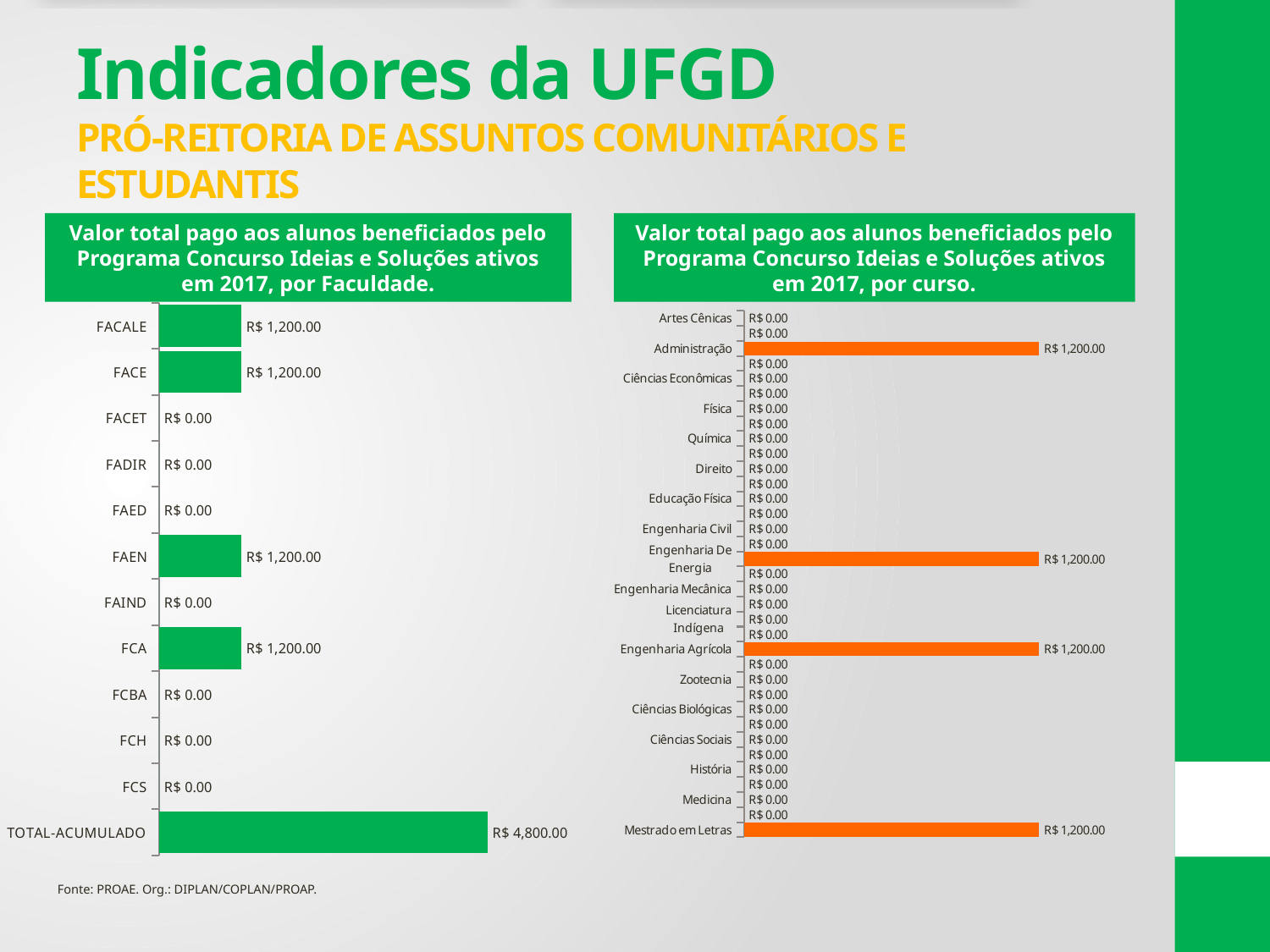
In the right chart (por curso), what is the value for Mestrado em Letras? R$ 1,200.00 In the right chart (por curso), what is the value for Administração? R$ 1,200.00 In the right chart (por curso), what is the value for Engenharia Agrícola? R$ 1,200.00 In the left chart (por Faculdade), what is the difference between TOTAL-ACUMULADO and FAEN? R$ 3,600.00 In the left chart (por Faculdade), what is the value for FACALE? R$ 1,200.00 What colour are the bars in the right chart (por curso)? Orange In the left chart (por Faculdade), which is larger, the value for FCA or the value for FCBA? FCA In the left chart (por Faculdade), which category has the highest value? TOTAL-ACUMULADO In the left chart (por Faculdade), what is the value for FACET? R$ 0.00 What type of chart is the left chart (por Faculdade)? Bar chart In the left chart (por Faculdade), how many categories are shown on the axis? 12 In the left chart (por Faculdade), what is the value for TOTAL-ACUMULADO? R$ 4,800.00